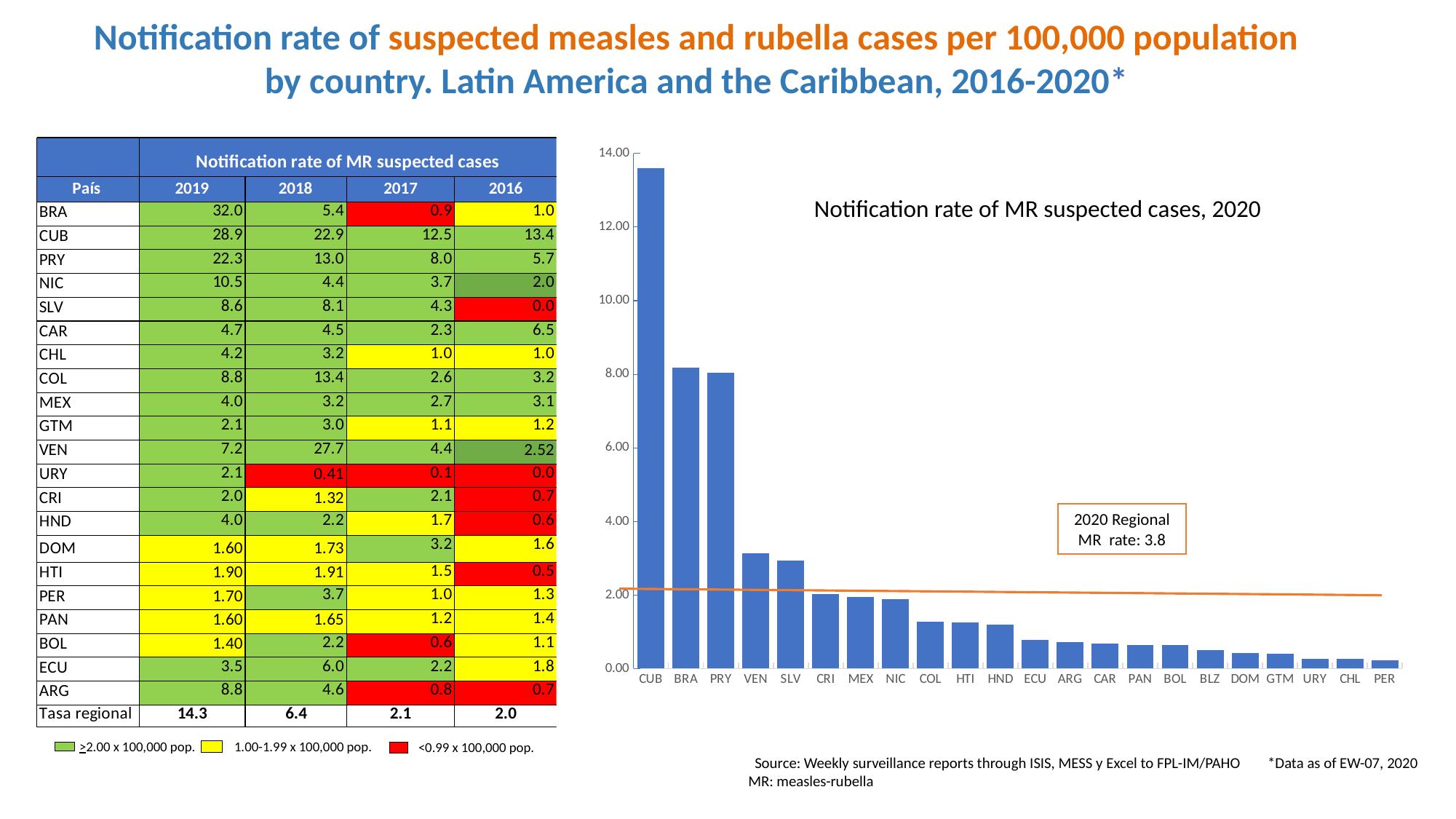
What kind of chart is shown on the right side of the slide? bar chart In the bar chart, which has the larger value, VEN or HTI? VEN In the bar chart, which has the larger value, CUB or BRA? CUB What 2020 regional MR rate is stated in the text box on the bar chart? 3.8 How many countries are plotted in the bar chart? 22 In the bar chart, do the values rise or fall from left to right along the x axis? fall In the bar chart, which country has the highest notification rate of MR suspected cases in 2020? CUB In the bar chart, is the value for SLV greater or less than 2.00? greater In the bar chart, is the value for VEN greater or less than 4.00? less In the bar chart, is the value for COL greater or less than 2.00? less